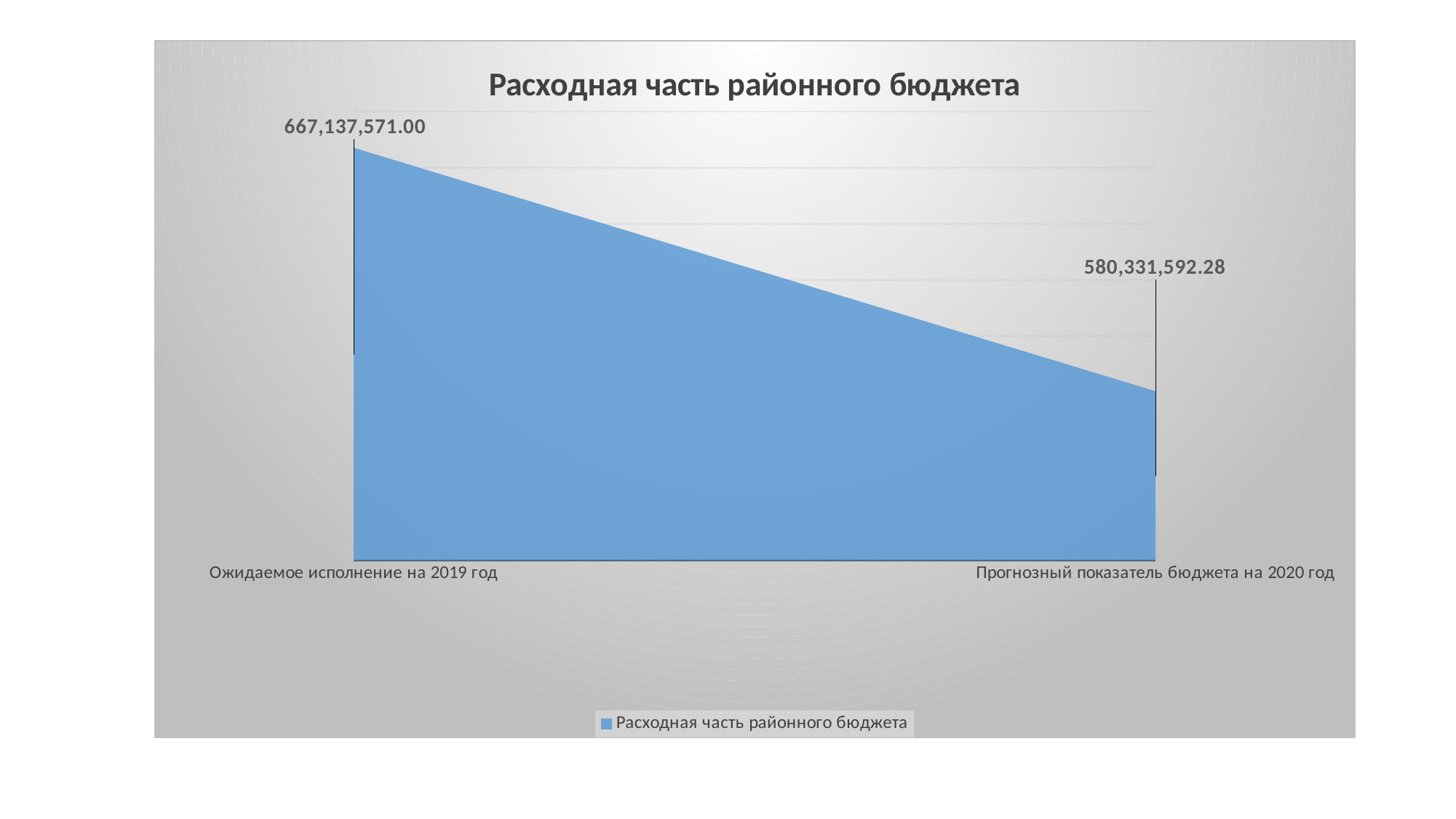
Which category has the lowest value? Прогнозный показатель бюджета на 2020 год What is the title of the chart? Расходная часть районного бюджета How many categories are plotted on the chart? 2 Which is larger: the value for "Ожидаемое исполнение на 2019 год" or the value for "Прогнозный показатель бюджета на 2020 год"? Ожидаемое исполнение на 2019 год What is the value for "Прогнозный показатель бюджета на 2020 год"? 580,331,592.28 What is the value for "Ожидаемое исполнение на 2019 год"? 667,137,571.00 How many series does the legend list? 1 What series name is shown in the legend? Расходная часть районного бюджета What kind of chart is shown on the slide? Area chart Which category has the highest value? Ожидаемое исполнение на 2019 год What is the difference between the value for "Ожидаемое исполнение на 2019 год" and the value for "Прогнозный показатель бюджета на 2020 год"? 86,805,978.72 Do the values rise or fall from the 2019 category to the 2020 category? Fall